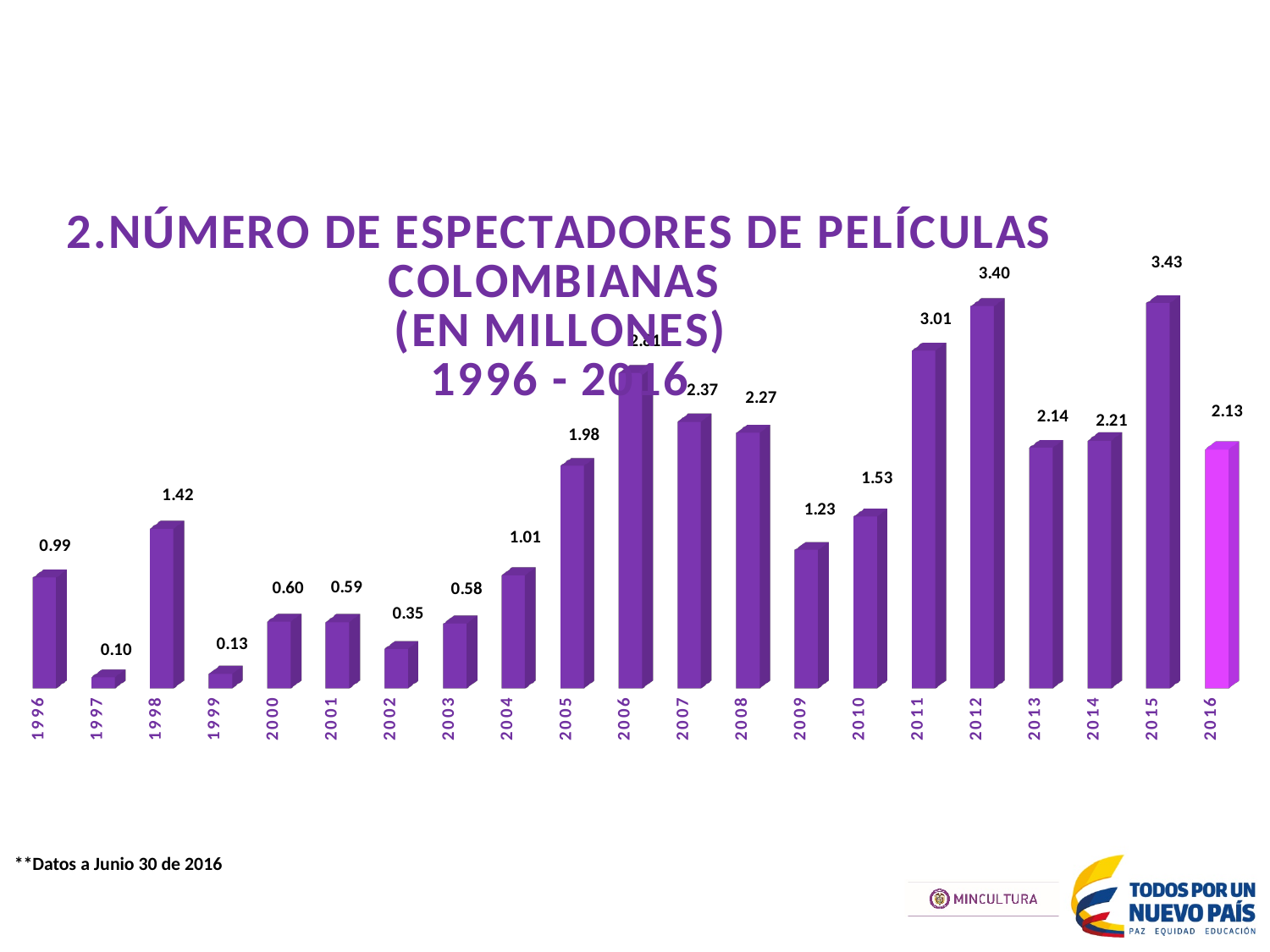
Which year has the highest number of viewers? 2015 What is the difference between the values for 2012 and 2011? 0.39 What is the number of viewers (in millions) for 2015? 3.43 What is the value shown for 2009? 1.23 How many years are shown on the x axis? 21 Which year has a larger value, 2007 or 2008? 2007 What is the difference between the values for 2014 and 2013? 0.07 What is the value shown for 2016? 2.13 Which year has the lowest number of viewers? 1997 What is the value shown for 1998? 1.42 Do the values rise or fall from 2001 to 2002? fall What type of chart is shown on the slide? bar chart